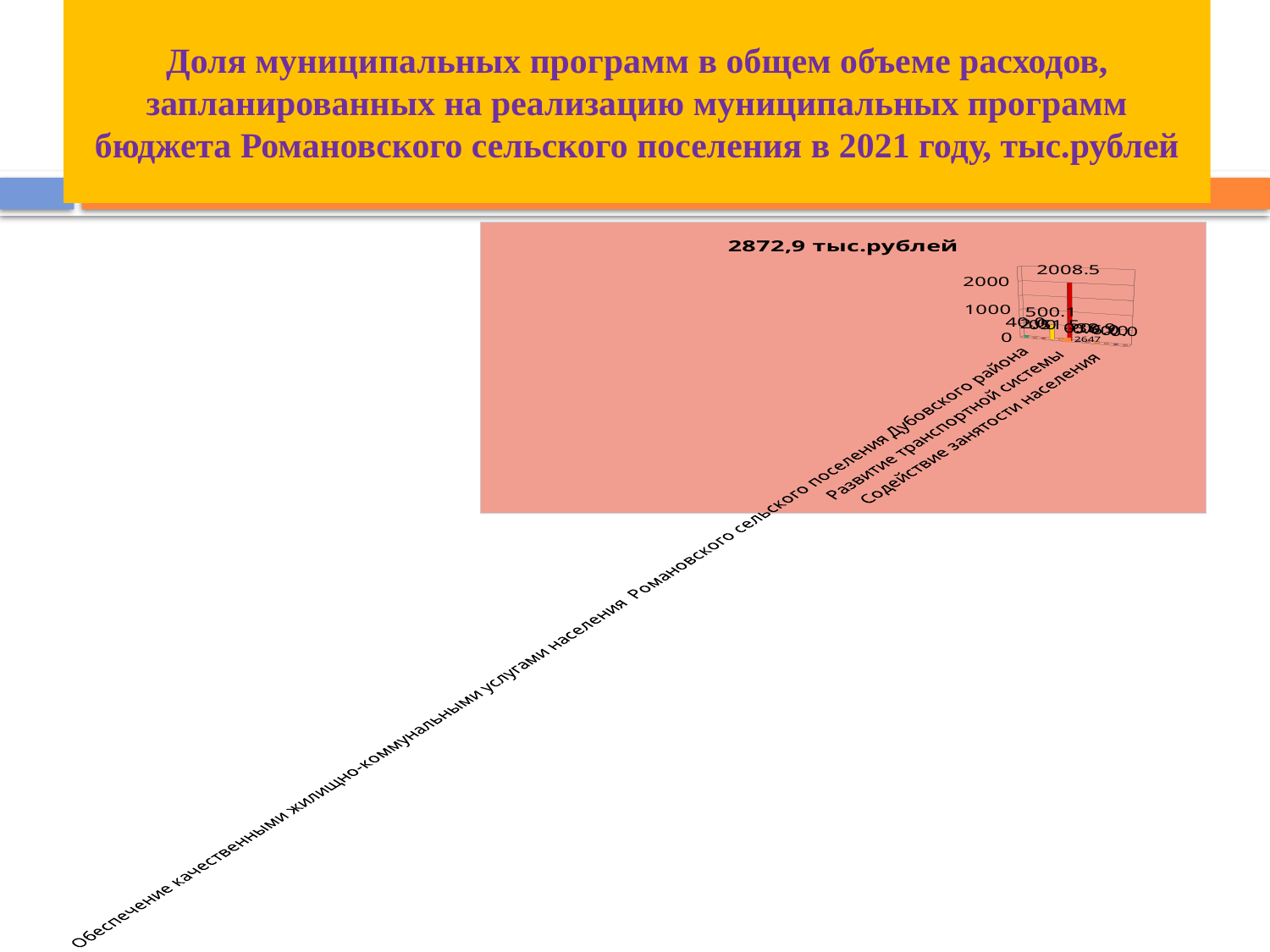
Which is larger, the bar labelled 2008.5 or the bar labelled 500.1? 2008.5 What is the highest tick value shown on the vertical axis? 2000 What is the title of the chart? 2872,9 тыс.рублей What kind of chart is shown on the slide? bar chart Is the tallest bar's value greater or less than 2000? greater What is the largest data label printed on the chart? 2008.5 Is the bar labelled 500.1 greater or less than 1000? less What is the difference between the two largest data labels, 2008.5 and 500.1? 1508.4